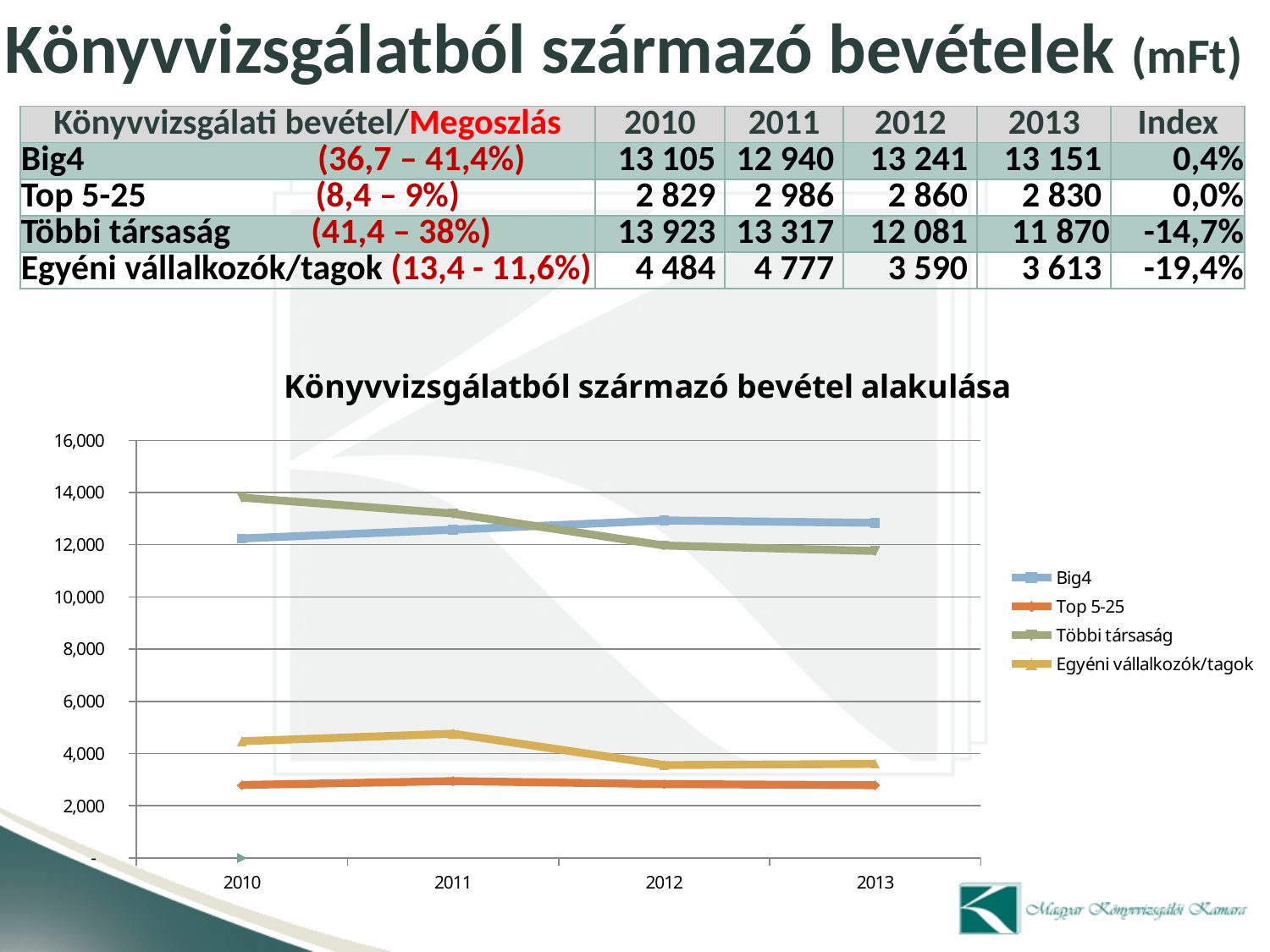
In 2012, which is larger: Big4 or Többi társaság? Big4 Which series has the lowest value in 2013? Top 5-25 Is the value for Big4 in 2013 greater or less than 12,000? greater Which series has the highest value in 2013? Big4 According to the table on the slide, what is the Big4 value for 2013? 13 151 How many series does the chart legend list? 4 Does the Többi társaság series rise or fall from 2010 to 2013? fall Is the value for Egyéni vállalkozók/tagok in 2012 greater or less than 4,000? less How many years are shown on the x axis of the chart? 4 Which series has the highest value in 2010? Többi társaság What is the title of the chart? Könyvvizsgálatból származó bevétel alakulása What type of chart is shown on the slide? line chart